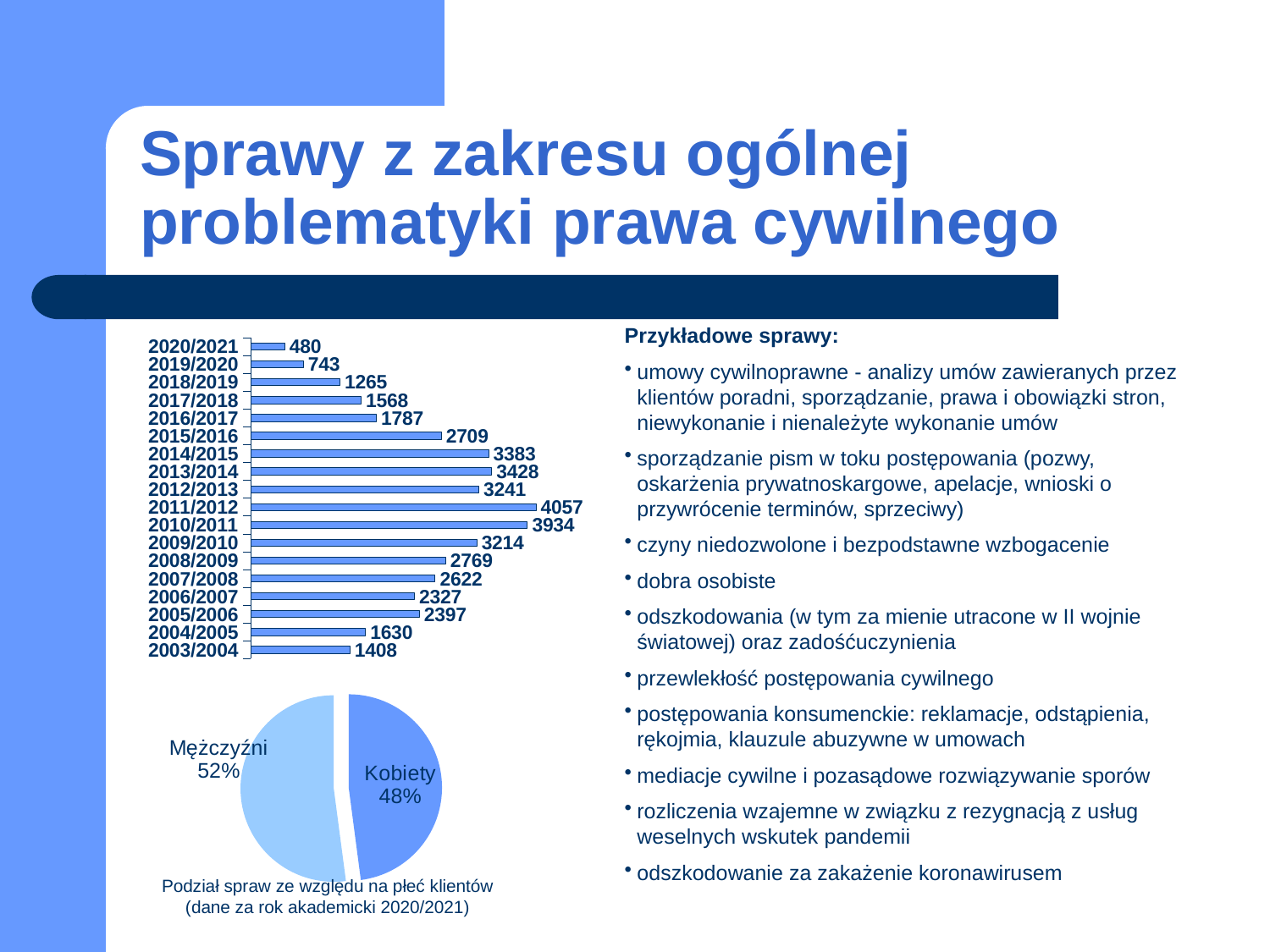
What kind of chart is the upper chart on the left? bar chart What is the caption below the pie chart at the bottom left? Podział spraw ze względu na płeć klientów (dane za rok akademicki 2020/2021) In the bar chart on the left, what is the value for 2003/2004? 1408 In the bar chart on the left, which academic year has the lowest value? 2020/2021 In the bar chart on the left, which academic year has the highest value? 2011/2012 In the bar chart on the left, what is the value for 2016/2017? 1787 In the bar chart on the left, which is larger, the value for 2013/2014 or the value for 2014/2015? 2013/2014 In the pie chart at the bottom left, which slice is larger, Mężczyźni or Kobiety? Mężczyźni In the bar chart on the left, what is the difference between the values for 2011/2012 and 2010/2011? 123 In the bar chart on the left, what is the value for 2011/2012? 4057 In the bar chart on the left, how many academic years are shown? 18 In the pie chart at the bottom left, what share is labelled Kobiety? 48%